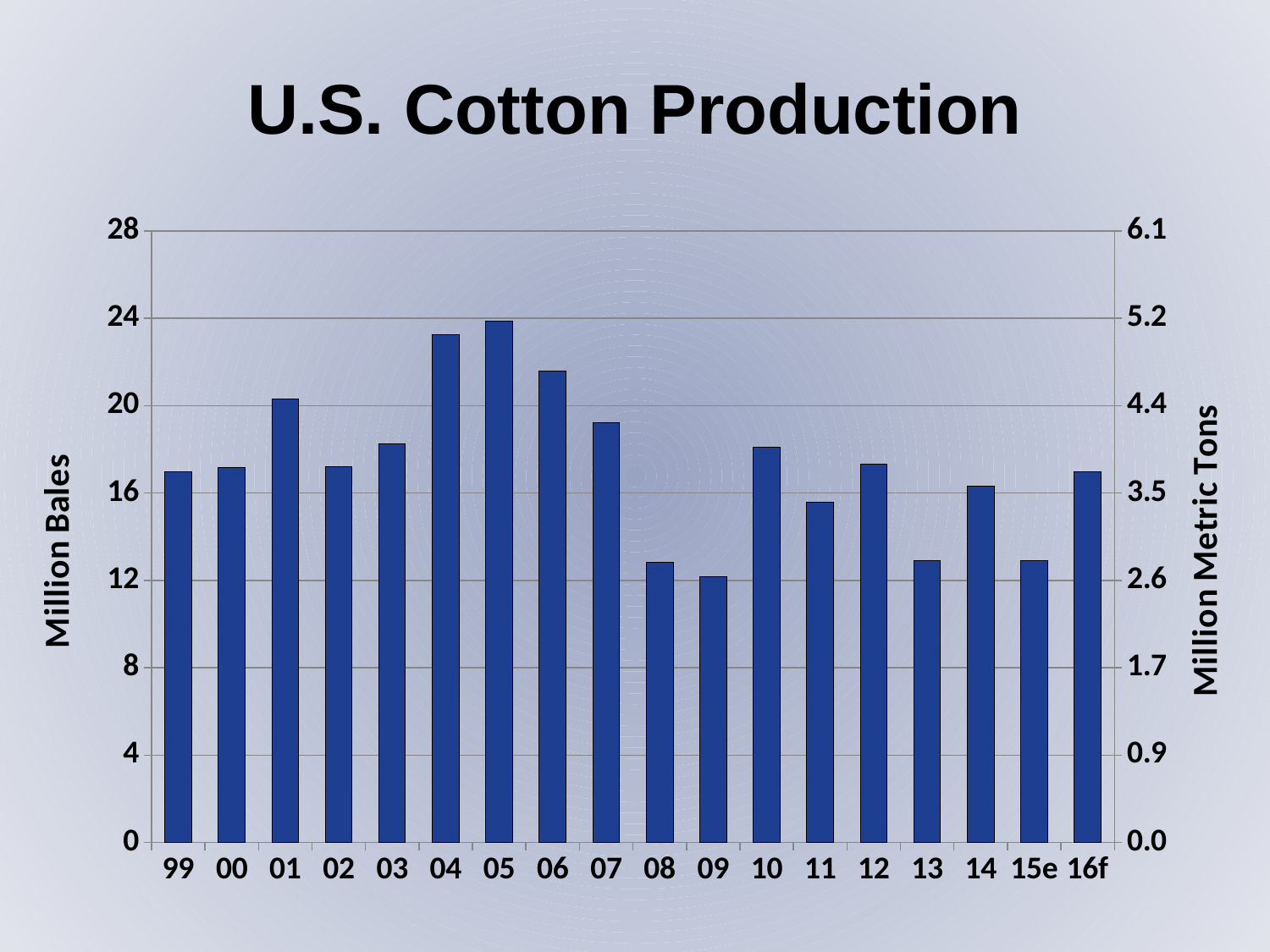
Which year has the larger production, 02 or 03? 03 Is the value for 07 greater or less than 20 million bales? less What kind of chart is shown on the slide? bar chart Is the value for 10 greater or less than 16 million bales? greater What is the label on the right-hand vertical axis? Million Metric Tons Which year has the highest U.S. cotton production? 05 Which year has the larger production, 04 or 06? 04 Which year has the lowest U.S. cotton production? 09 How many years (bars) are plotted on the chart? 18 Is the value for 11 greater or less than 16 million bales? less Do the values rise or fall from 06 to 09? fall